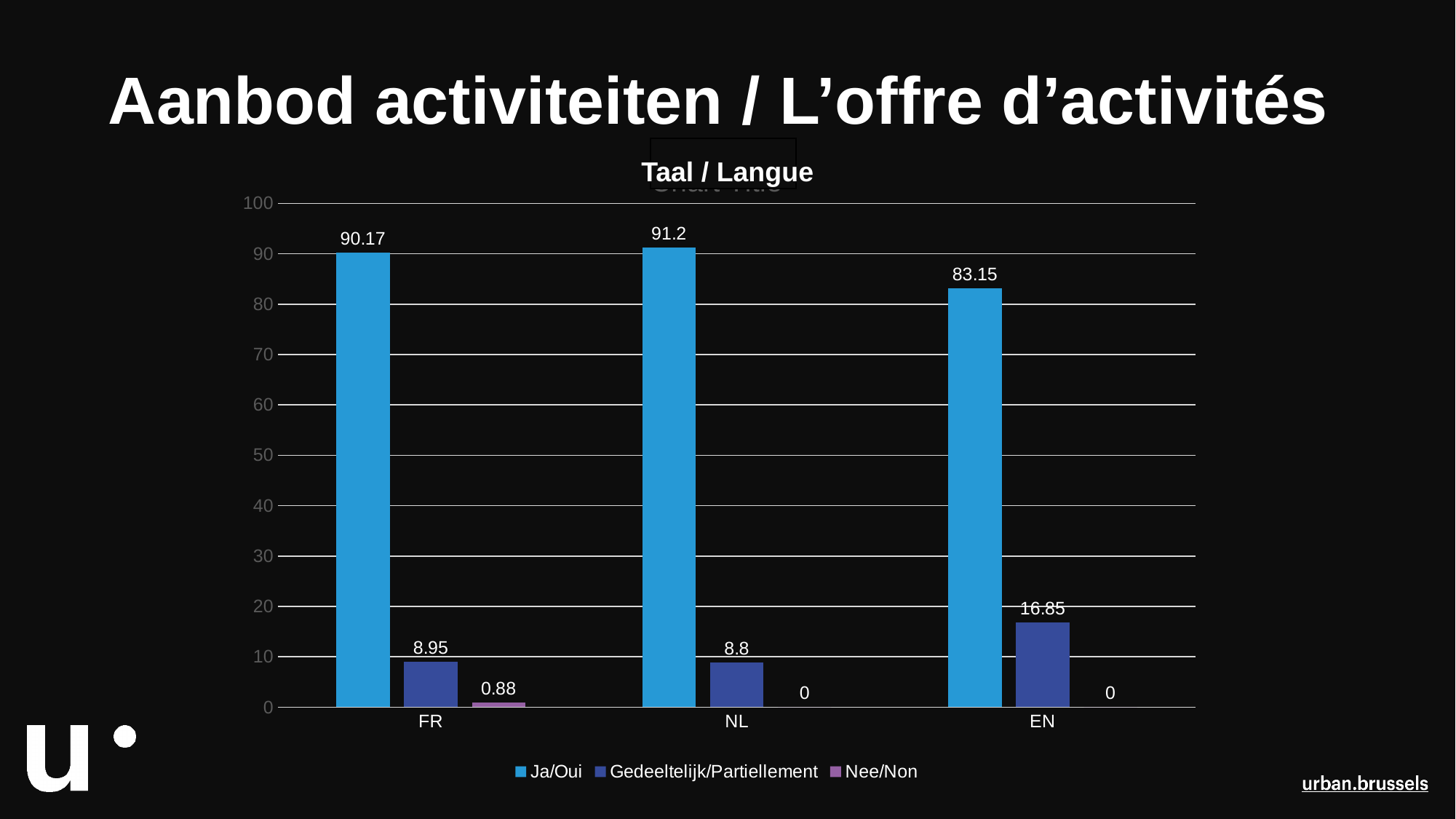
What is the title of the chart? Taal / Langue Which language has the highest Ja/Oui value? NL What is the Ja/Oui value for FR? 90.17 What is the Ja/Oui value for NL? 91.2 How many series does the legend list? 3 How many language categories are shown on the x axis? 3 What is the Gedeeltelijk/Partiellement value for EN? 16.85 What kind of chart is shown on the slide? Bar chart Which is larger, the Gedeeltelijk/Partiellement value for FR or for EN? EN What is the difference between the Ja/Oui values for NL and EN? 8.05 What is the Nee/Non value for FR? 0.88 Which language has the lowest Ja/Oui value? EN